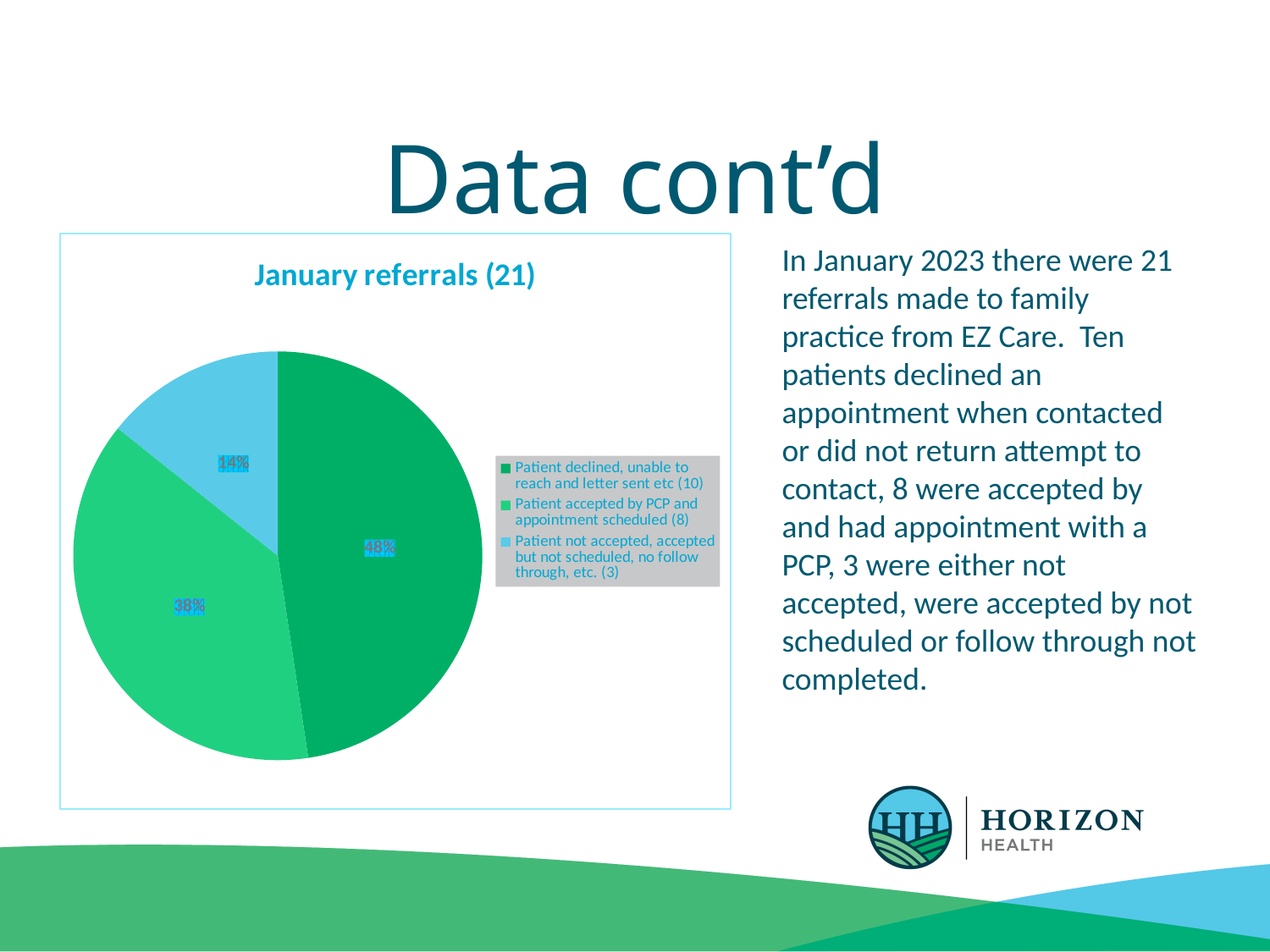
How many slices does the pie chart have? 3 How many entries does the chart legend list? 3 Which category has the largest slice of the pie? Patient declined, unable to reach and letter sent etc (10) What colour is the slice for 'Patient not accepted, accepted but not scheduled, no follow through, etc. (3)'? light blue What percentage of the pie is labelled for 'Patient not accepted, accepted but not scheduled, no follow through, etc. (3)'? 14% What is the title of the chart? January referrals (21) Which category has the smallest slice of the pie? Patient not accepted, accepted but not scheduled, no follow through, etc. (3) What percentage of the pie is labelled for 'Patient declined, unable to reach and letter sent etc (10)'? 48% What is the difference in percentage points between the 48% slice and the 38% slice? 10 What percentage of the pie is labelled for 'Patient accepted by PCP and appointment scheduled (8)'? 38% What kind of chart is shown on the slide? pie chart Which slice is larger: 'Patient accepted by PCP and appointment scheduled (8)' or 'Patient not accepted, accepted but not scheduled, no follow through, etc. (3)'? Patient accepted by PCP and appointment scheduled (8)